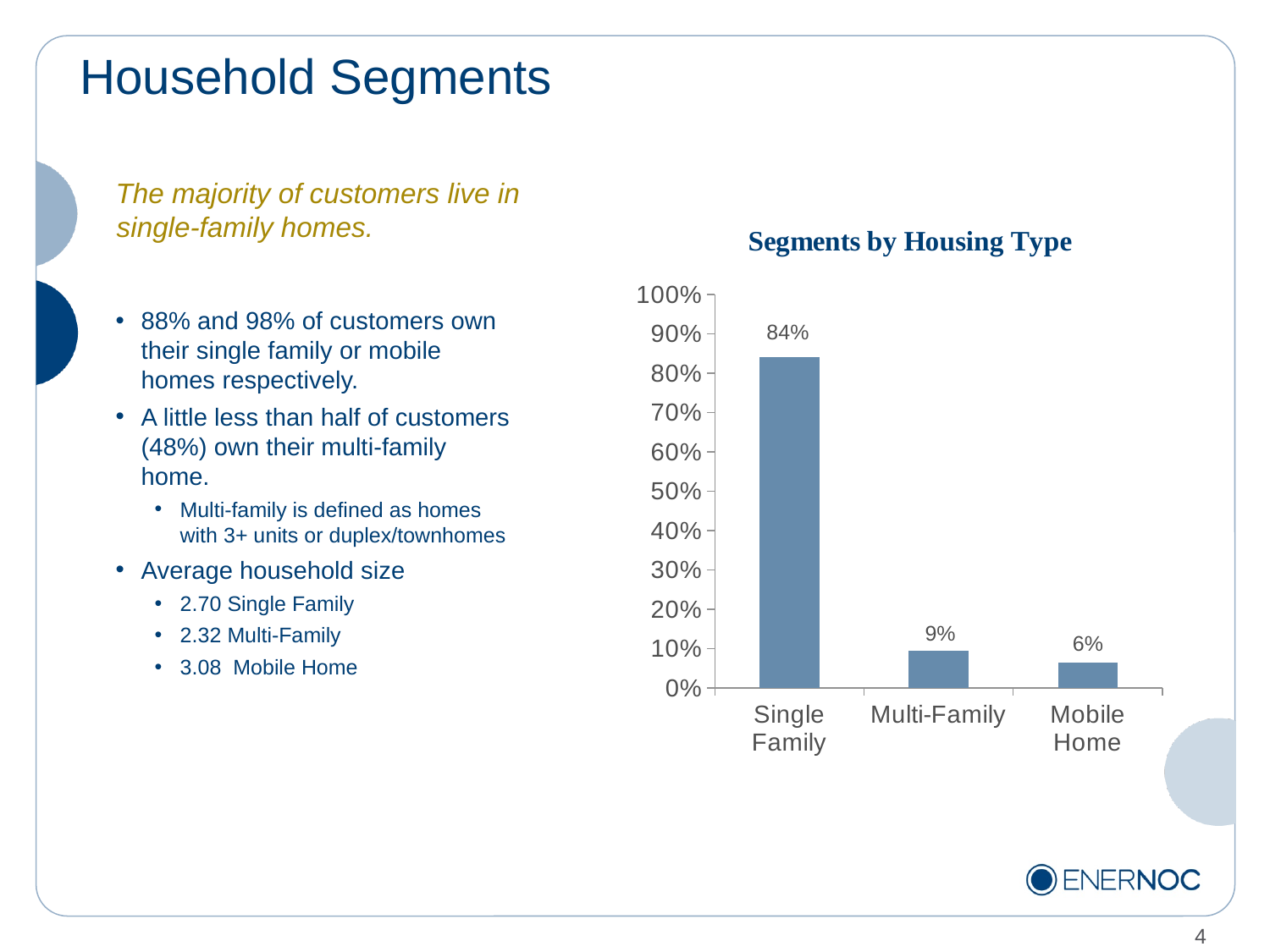
What is the difference between the Multi-Family and Mobile Home values? 3% What is the title of the chart on the slide? Segments by Housing Type What kind of chart is shown on the slide? Bar chart What is the difference between the Single Family and Multi-Family values? 75% Is the value for Single Family greater or less than 80%? greater Which is larger, the value for Multi-Family or the value for Mobile Home? Multi-Family Which housing type has the lowest value in the chart? Mobile Home What is the value for Mobile Home in the Segments by Housing Type chart? 6% What is the value for Multi-Family in the Segments by Housing Type chart? 9% Which housing type has the highest value in the chart? Single Family How many housing type categories are shown in the chart? 3 What is the value for Single Family in the Segments by Housing Type chart? 84%